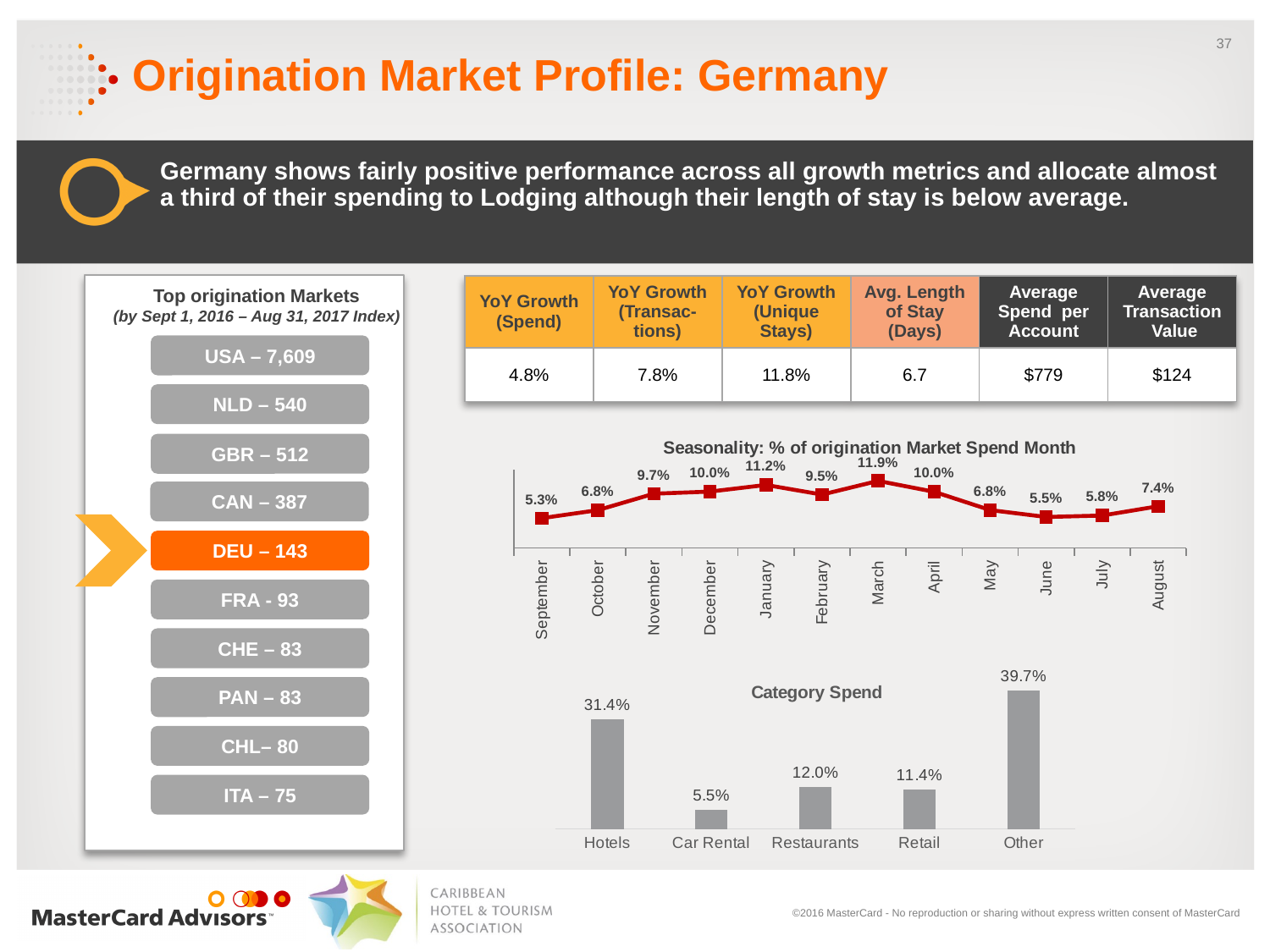
In the Seasonality chart, which month has the lowest value? September In the Seasonality chart, what is the value for September? 5.3% What kind of chart is the Seasonality chart? Line chart In the Seasonality chart, what is the value for March? 11.9% In the Category Spend chart, which is larger, Restaurants or Retail? Restaurants In the Category Spend chart, which category has the highest value? Other In the Seasonality chart, which month has the highest value? March In the Seasonality chart, what is the difference between January and February? 1.7% In the Category Spend chart, which category has the lowest value? Car Rental What kind of chart is the Category Spend chart? Bar chart In the Seasonality chart, how many months are plotted? 12 In the Category Spend chart, what is the value for Hotels? 31.4%